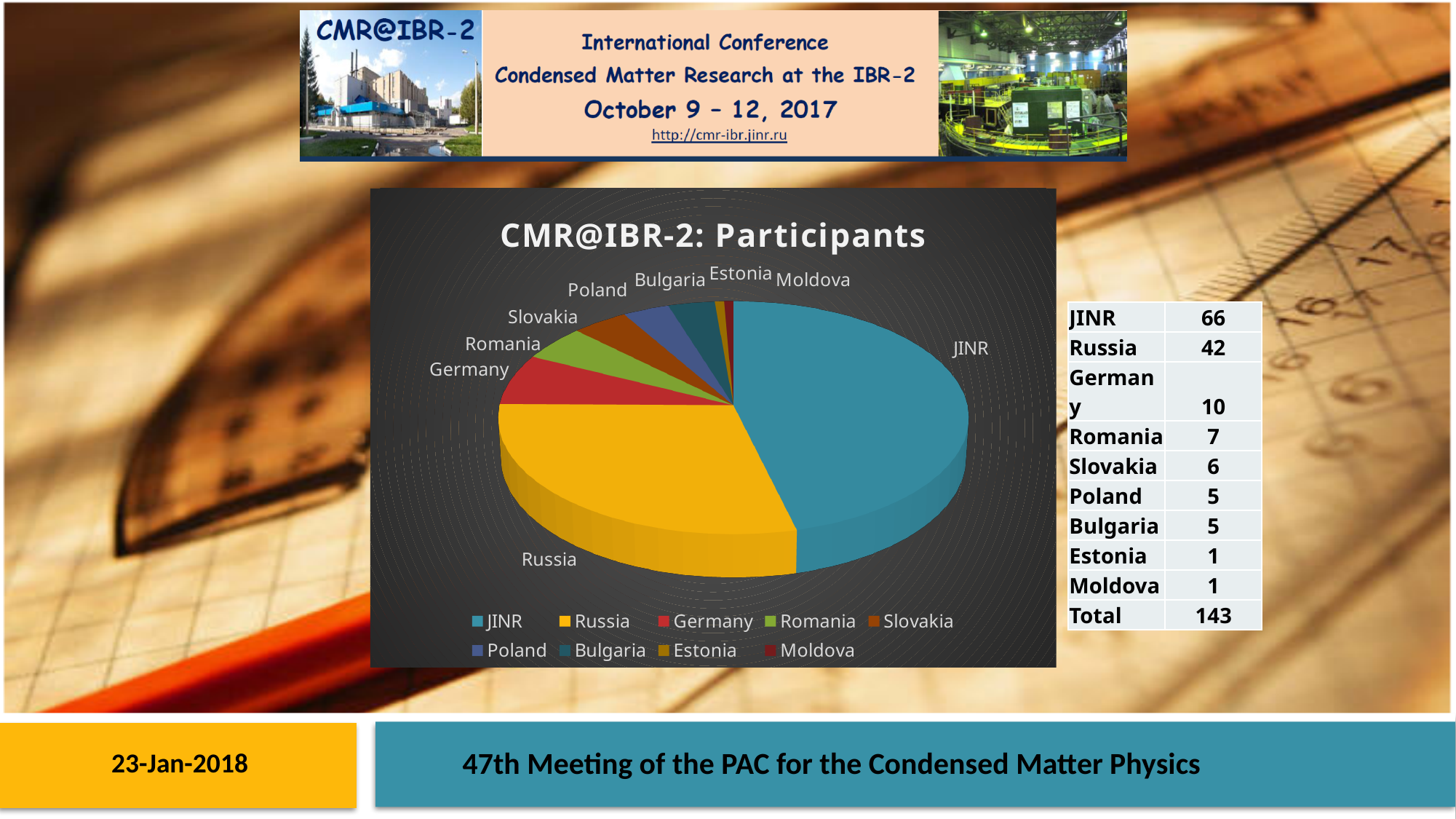
What kind of chart is shown on the slide? pie chart How many participants are from JINR? 66 How many participants are from Slovakia? 6 Which has more participants, Russia or Germany? Russia How many participants are from Germany? 10 What is the total number of participants shown in the table? 143 What colour is the Russia slice in the pie chart? yellow How many participants are from Russia? 42 What is the difference between the number of participants from JINR and from Russia? 24 Which category has the largest slice of the pie? JINR How many categories does the pie chart have? 9 What is the title of the chart? CMR@IBR-2: Participants